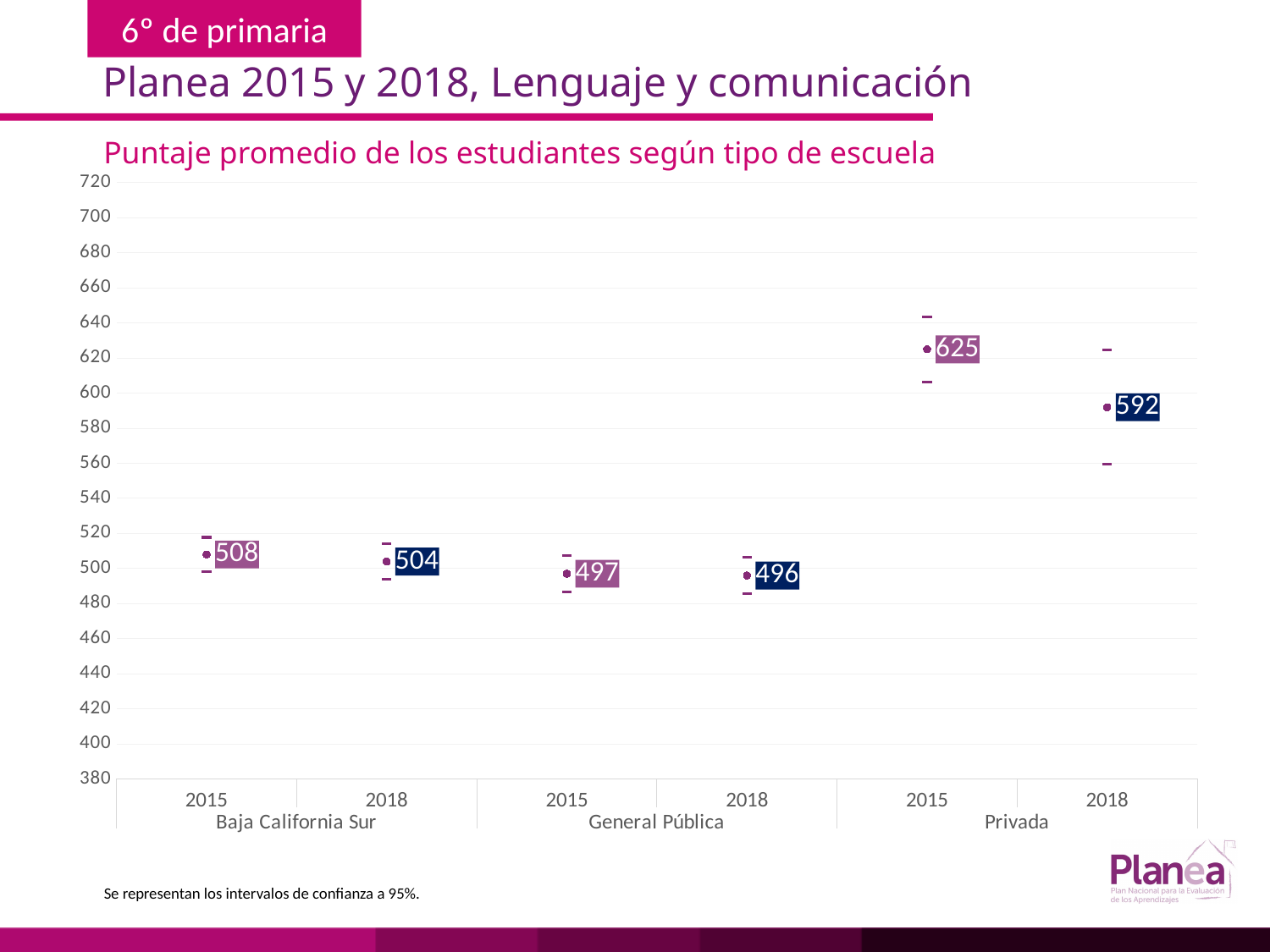
What is the difference between the Privada scores in 2015 and 2018? 33 Is the Privada 2015 score greater or less than 600? greater What is the title of the chart? Puntaje promedio de los estudiantes según tipo de escuela Did the Privada average score rise or fall from 2015 to 2018? fall What is the average score for General Pública schools in 2015? 497 Which school type and year has the lowest average score? General Pública 2018 Which is larger, the Baja California Sur 2018 score or the General Pública 2018 score? Baja California Sur 2018 What is the difference between the Baja California Sur scores in 2015 and 2018? 4 What is the average score for Privada schools in 2018? 592 What is the average score for Baja California Sur in 2015? 508 Which school type and year has the highest average score? Privada 2015